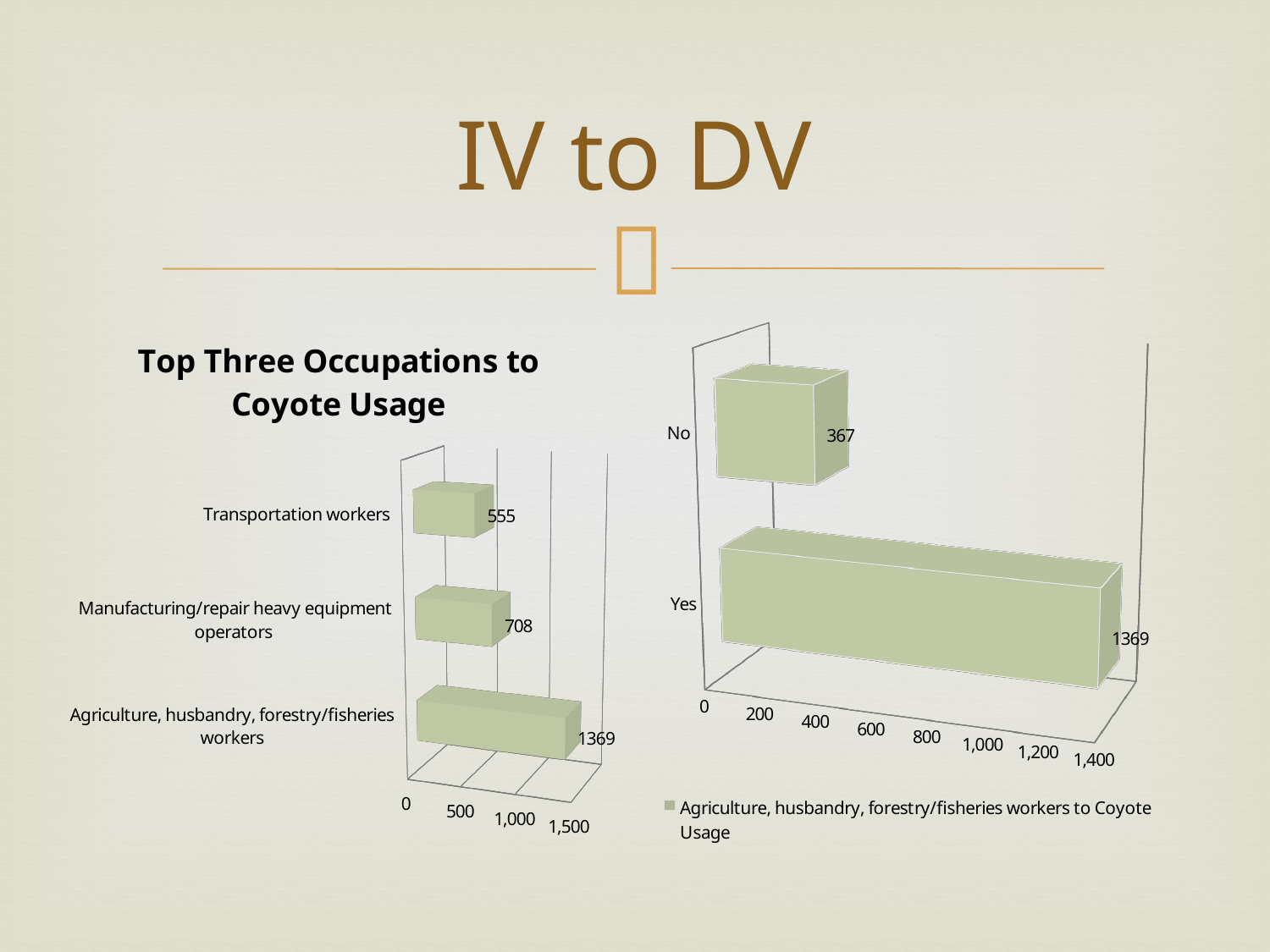
In the chart on the right, which is larger, the value for 'Yes' or the value for 'No'? Yes In the chart on the right, what is the value for 'No'? 367 In the 'Top Three Occupations to Coyote Usage' chart, what is the value for Transportation workers? 555 In the 'Top Three Occupations to Coyote Usage' chart, what is the value for Manufacturing/repair heavy equipment operators? 708 In the chart on the right, what is the difference between the values for 'Yes' and 'No'? 1002 In the chart on the right, what is the value for 'Yes'? 1369 In the 'Top Three Occupations to Coyote Usage' chart, which occupation has the lowest value? Transportation workers In the chart on the right, what series name does the legend show? Agriculture, husbandry, forestry/fisheries workers to Coyote Usage In the 'Top Three Occupations to Coyote Usage' chart, how many occupation categories are shown? 3 In the 'Top Three Occupations to Coyote Usage' chart, which occupation has the highest value? Agriculture, husbandry, forestry/fisheries workers What kind of chart is the 'Top Three Occupations to Coyote Usage' chart? Bar chart In the 'Top Three Occupations to Coyote Usage' chart, what is the difference between the values for Agriculture, husbandry, forestry/fisheries workers and Transportation workers? 814